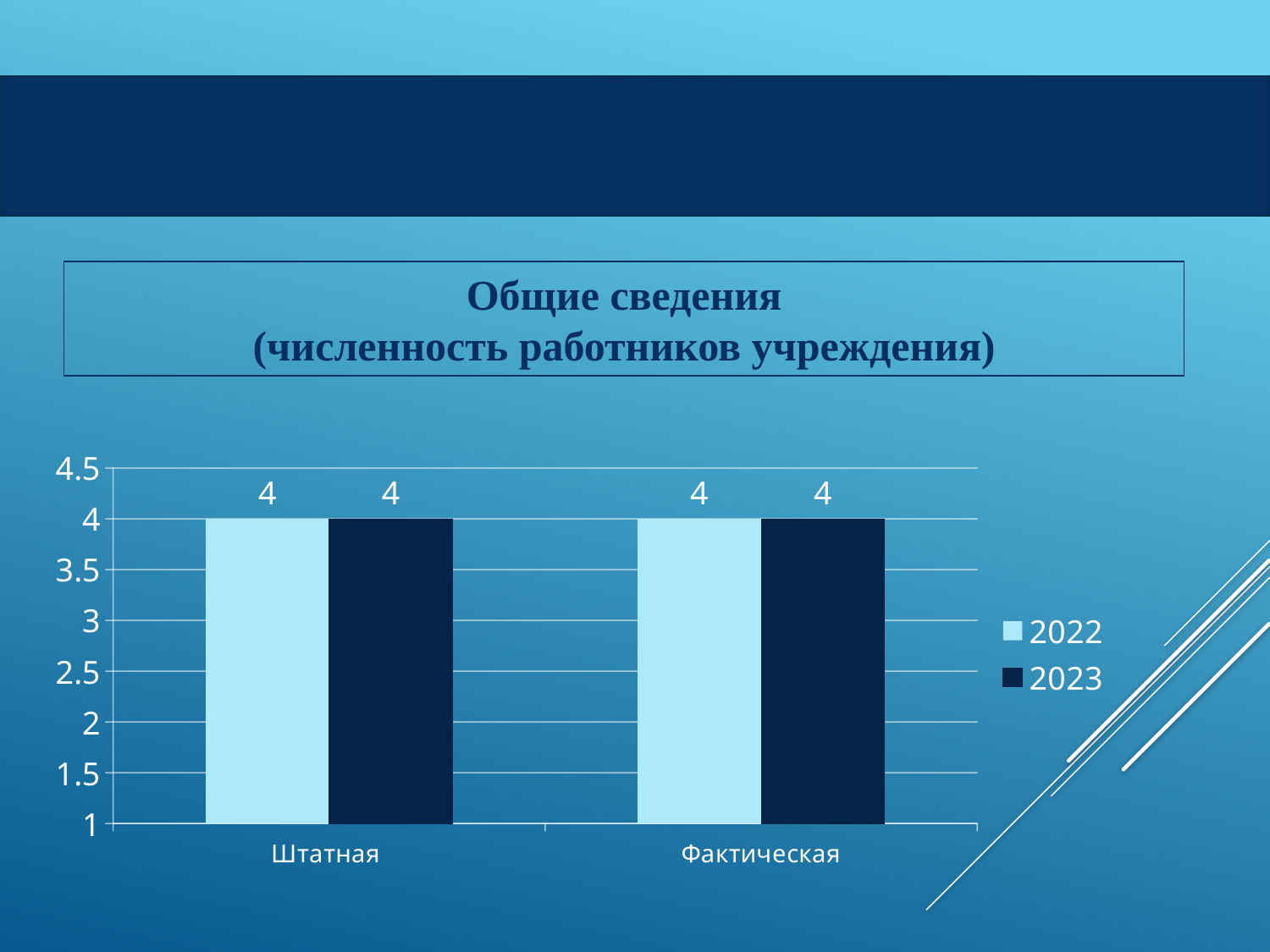
What is the title shown above the chart? Общие сведения (численность работников учреждения) What is the difference between the Штатная and Фактическая values in 2022? 0 What is the value for Фактическая in 2023? 4 Which series does the legend list first? 2022 Is the value for Штатная in 2023 greater or less than 3? greater What kind of chart is shown on the slide? bar chart How many categories are shown on the x axis? 2 What is the value for Фактическая in 2022? 4 What is the difference between the 2022 and 2023 values for Штатная? 0 How many series does the legend list? 2 What is the value for Штатная in 2022? 4 What is the value for Штатная in 2023? 4